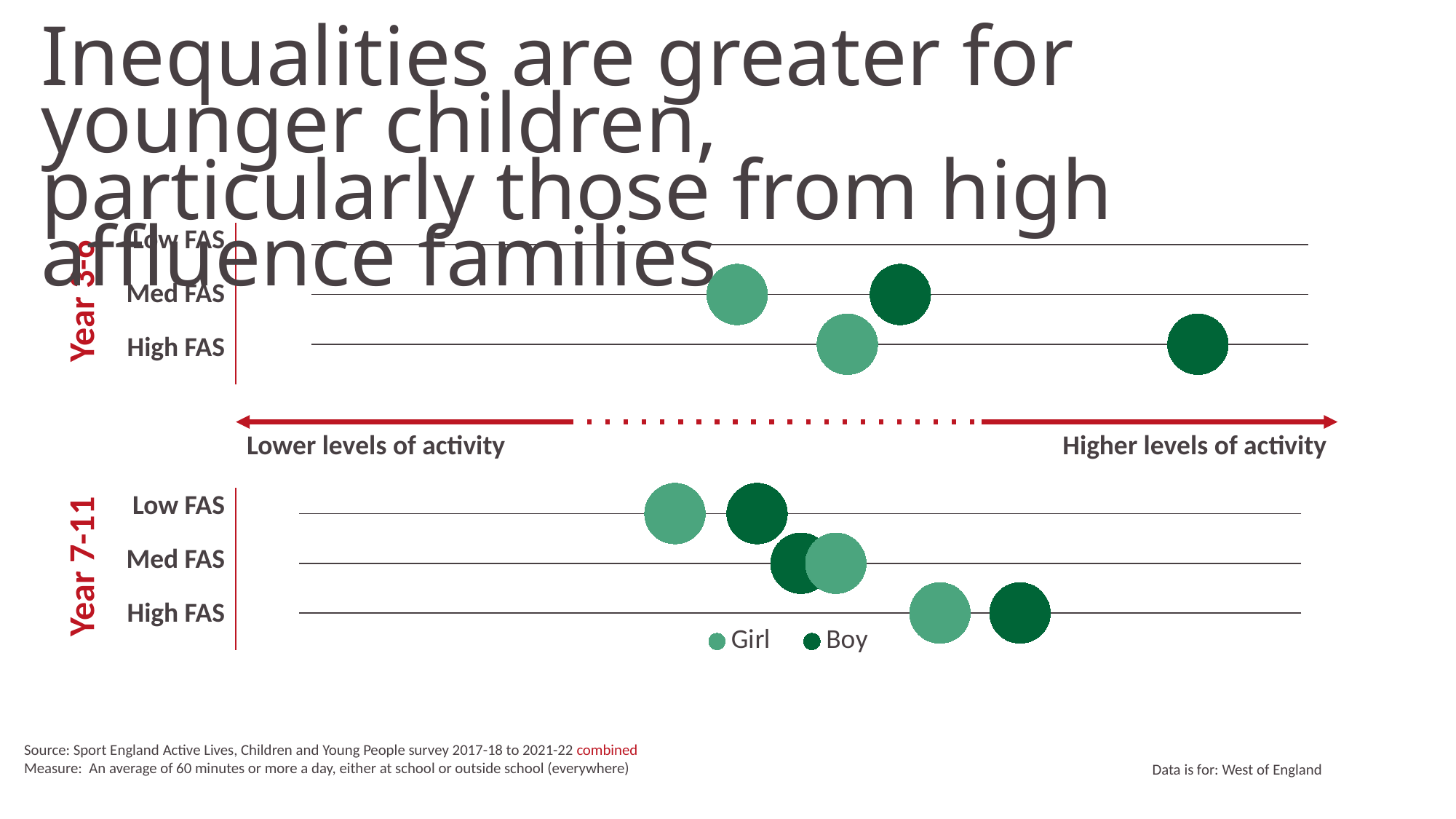
In the Year 7-11 chart, for High FAS, which has the higher level of activity, Girl or Boy? Boy What are the two series named in the legend? Girl and Boy In the Year 7-11 chart, how many FAS categories are plotted? 3 In the Year 3-6 chart, for High FAS, which has the higher level of activity, Girl or Boy? Boy In the Year 7-11 chart, which FAS group has the highest level of activity for boys? High FAS In the Year 7-11 chart, for Low FAS, which has the higher level of activity, Girl or Boy? Boy How many series does the legend list? 2 In the Year 7-11 chart, do activity levels for girls rise or fall going from Low FAS to High FAS? rise In the Year 7-11 chart, which FAS group has the lowest level of activity for girls? Low FAS Which colour represents the Girl series in the charts? light green What kind of chart is used on this slide to show activity levels by family affluence? bubble chart